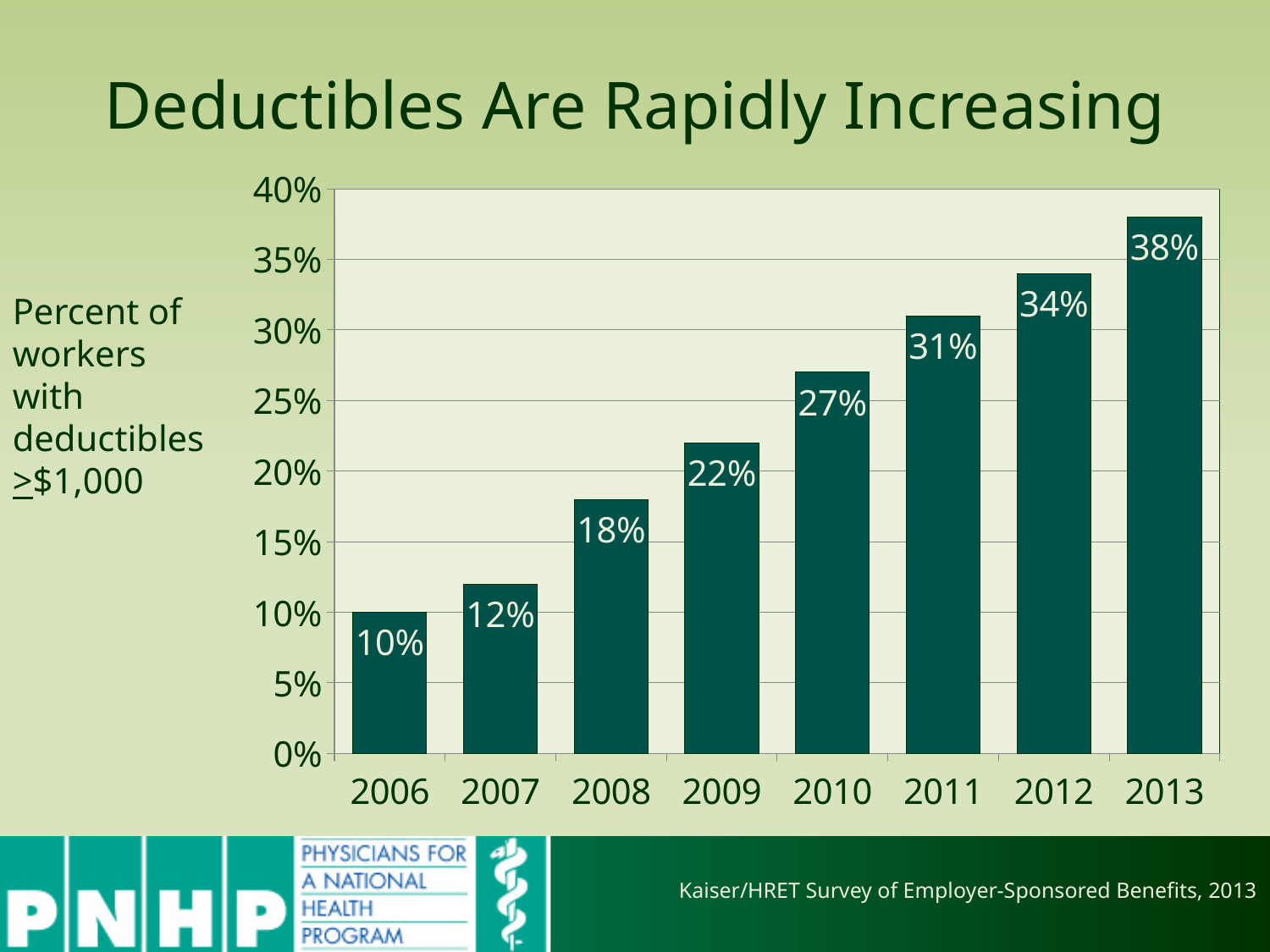
Do the values rise or fall from 2006 to 2013? Rise Is the value for 2009 greater or less than 20%? greater By how many percentage points did the value increase from 2006 to 2013? 28 percentage points Which is larger, the value for 2011 or the value for 2012? 2012 Which year has the highest percent of workers with deductibles of $1,000 or more? 2013 What kind of chart is shown on the slide? Bar chart What percent of workers had deductibles of $1,000 or more in 2006? 10% What is the difference between the values for 2009 and 2008? 4 percentage points What is the value shown for 2013? 38% What is the value shown for 2010? 27% Which year has the lowest value on the chart? 2006 How many years are shown on the x axis? 8